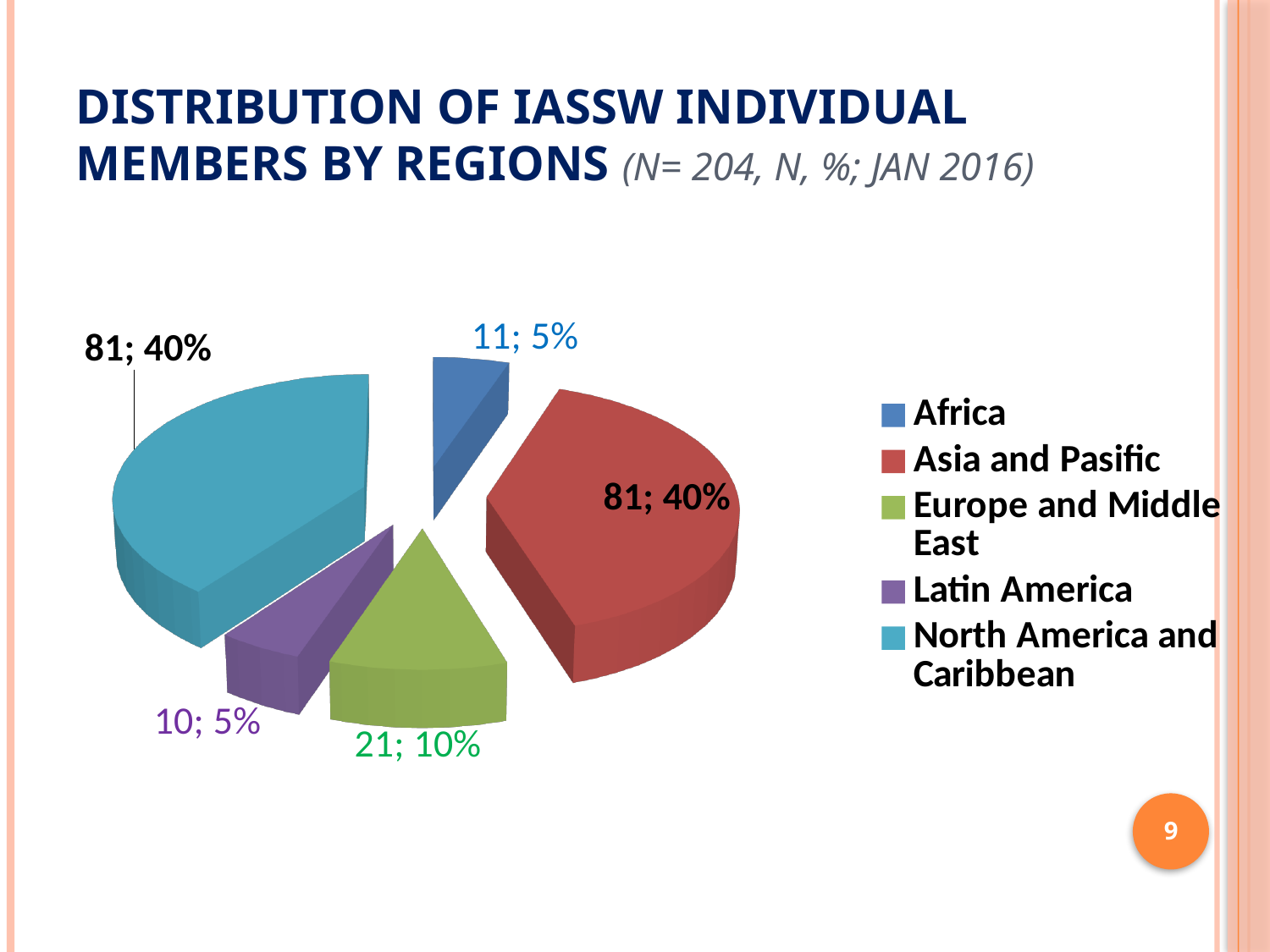
What is the difference in members between North America and Caribbean and Europe and Middle East? 60 Which colour represents North America and Caribbean in the chart? Light blue What is the number of members and percentage shown for Africa? 11; 5% What is the number of members shown for Europe and Middle East? 21 What is the total N stated in the chart title? 204 What type of chart is shown on the slide? Pie chart Which has more members, Africa or Latin America? Africa What is the difference in members between Europe and Middle East and Africa? 10 What percentage share of the pie does Latin America have? 5% How many regions does the legend list? 5 Which region has the lowest number of members? Latin America What percentage share of the pie does Asia and Pasific have? 40%